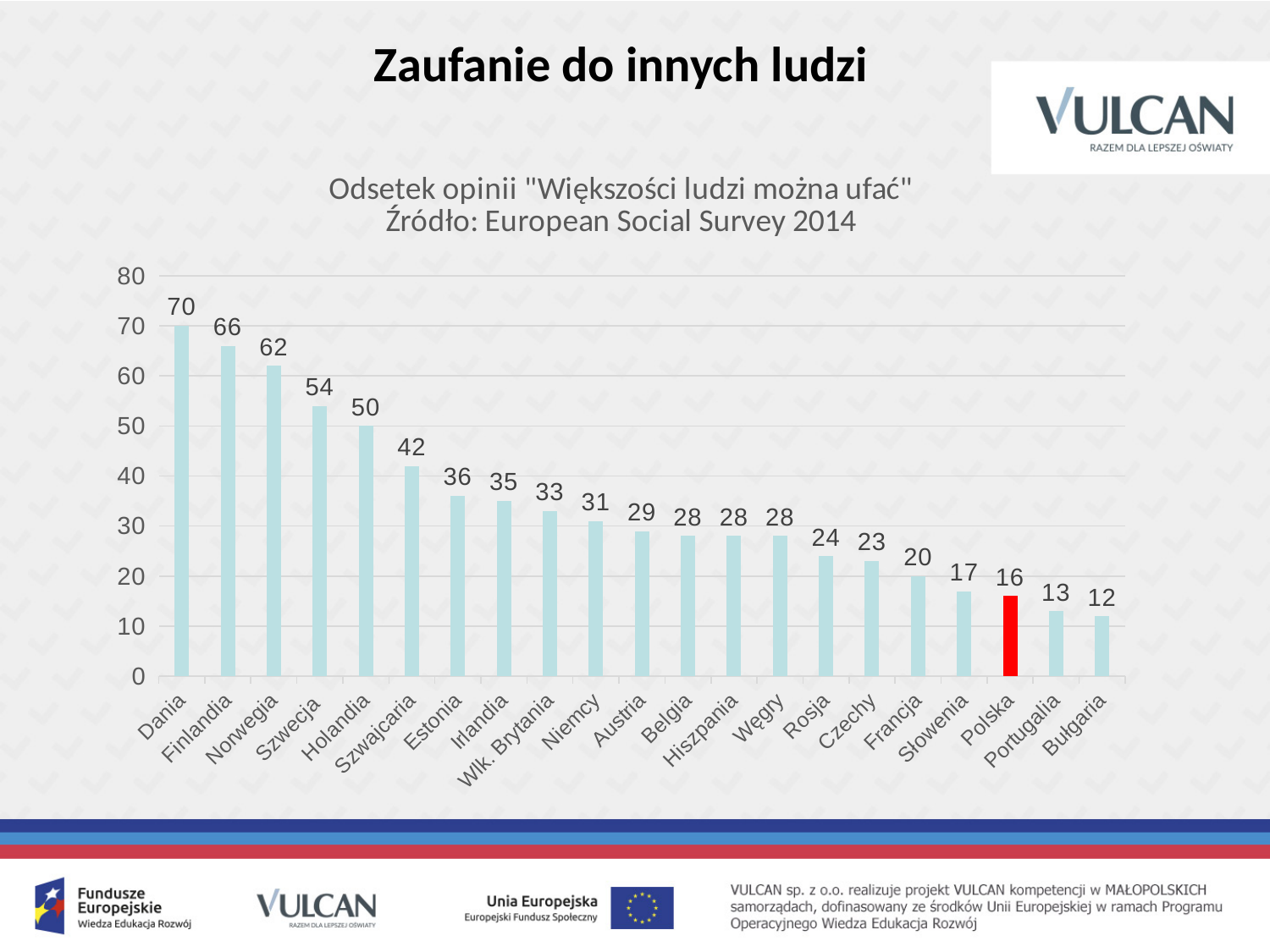
Which has a larger value, Szwecja or Holandia? Szwecja Which country's bar is coloured red? Polska Which country has the lowest value? Bułgaria Is the value for Estonia greater or less than 30? greater Do the values rise or fall from left to right along the x axis? fall Which country has the highest value? Dania How many countries are shown on the chart? 21 What is the value for Polska? 16 What is the value for Niemcy? 31 What is the value for Dania? 70 What is the difference between the values for Dania and Polska? 54 What kind of chart is shown on the slide? bar chart